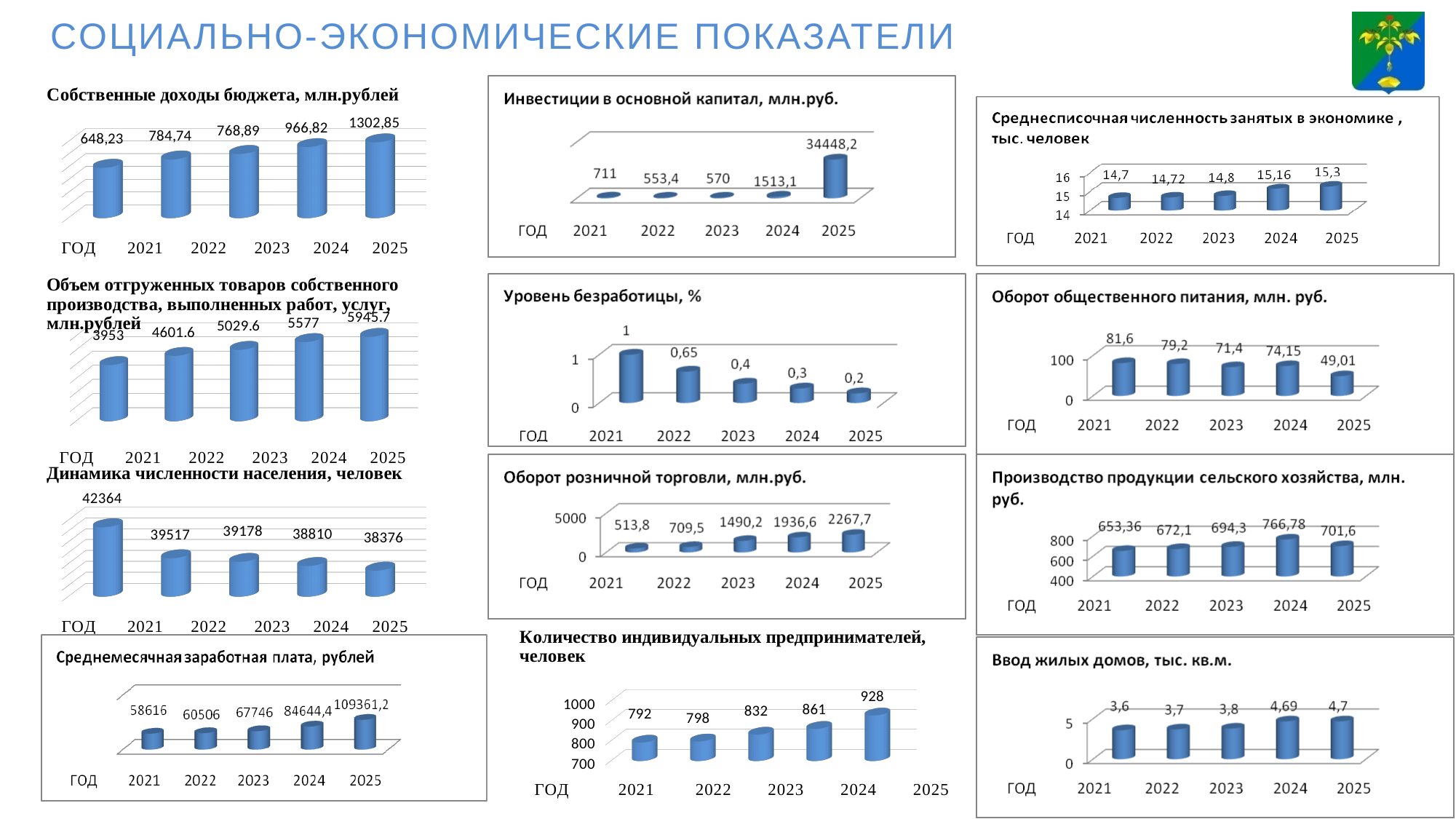
In the chart 'Инвестиции в основной капитал, млн.руб.', which year has the highest value? 2025 In the chart 'Динамика численности населения, человек', what is the difference between the 2021 and 2025 values? 3988 How many years are shown on the x axis of the chart 'Среднесписочная численность занятых в экономике, тыс. человек'? 5 In the chart 'Собственные доходы бюджета, млн.рублей', what is the value for 2025? 1302,85 In the chart 'Оборот общественного питания, млн. руб.', which year has the lowest value? 2025 In the chart 'Среднемесячная заработная плата, рублей', what is the value for 2024? 84644,4 In the chart 'Уровень безработицы, %', what is the value for 2022? 0,65 In the chart 'Количество индивидуальных предпринимателей, человек', what is the highest value shown? 928 What kind of chart is 'Объем отгруженных товаров собственного производства, выполненных работ, услуг, млн.рублей'? bar chart In the chart 'Оборот розничной торговли, млн.руб.', do the values rise or fall from 2021 to 2025? rise In the chart 'Производство продукции сельского хозяйства, млн. руб.', which is larger, the value for 2024 or the value for 2025? 2024 In the chart 'Ввод жилых домов, тыс. кв.м.', what is the value for 2023? 3,8